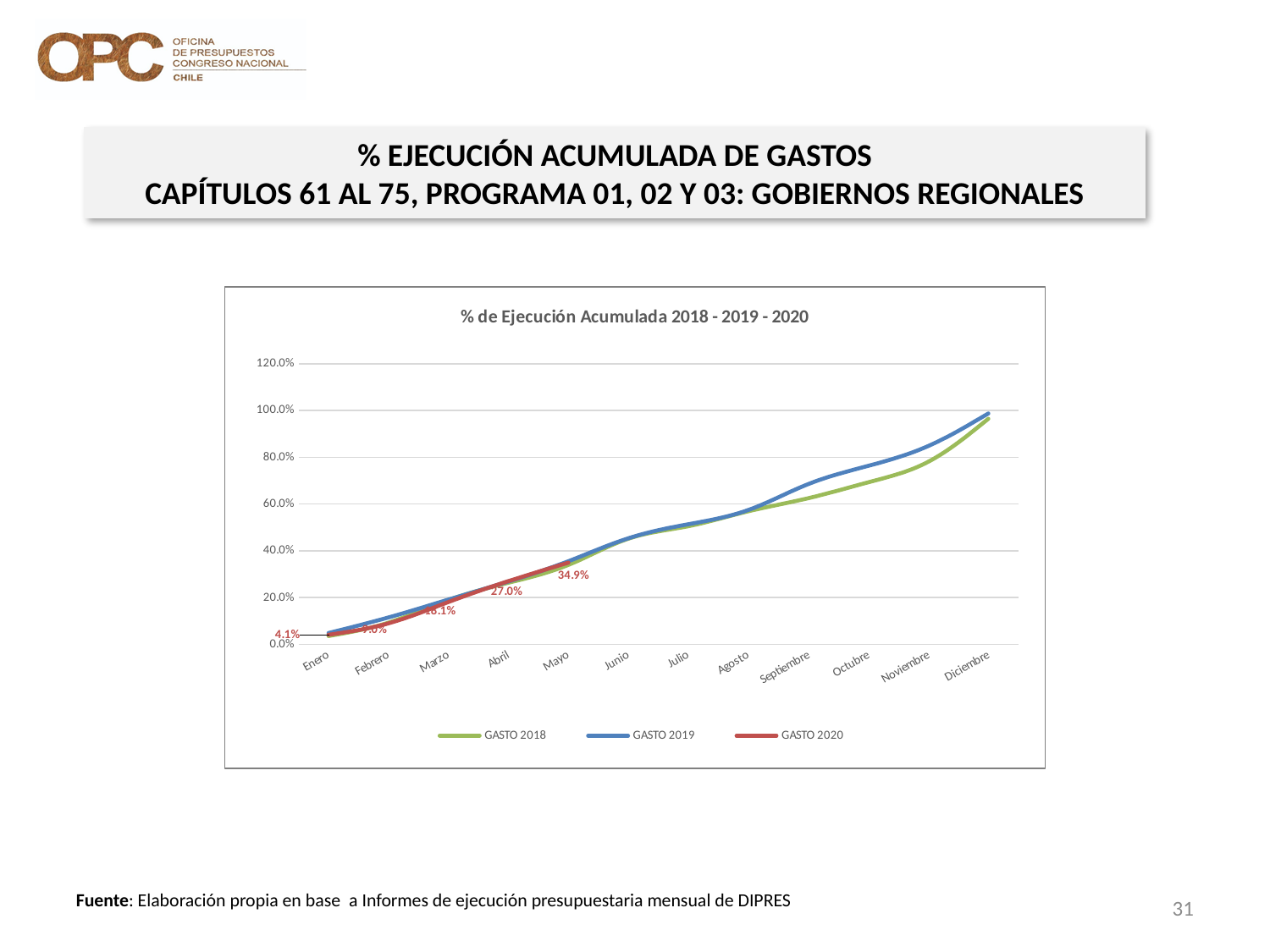
What is the value for GASTO 2020 in Abril? 27.0% Do the values for GASTO 2019 rise or fall from Enero to Diciembre? Rise What kind of chart is shown on the slide? Line chart By how much did GASTO 2020 increase from Abril to Mayo? 7.9 percentage points Is the value for GASTO 2018 in Septiembre greater or less than 80%? less What is the title of the chart? % de Ejecución Acumulada 2018 - 2019 - 2020 How many months are shown along the x axis of the chart? 12 What is the value for GASTO 2020 in Enero? 4.1% What is the value for GASTO 2020 in Mayo? 34.9% How many series does the chart legend list? 3 In Octubre, which series has the higher value, GASTO 2018 or GASTO 2019? GASTO 2019 Is the value for GASTO 2019 in Diciembre greater or less than 80%? greater